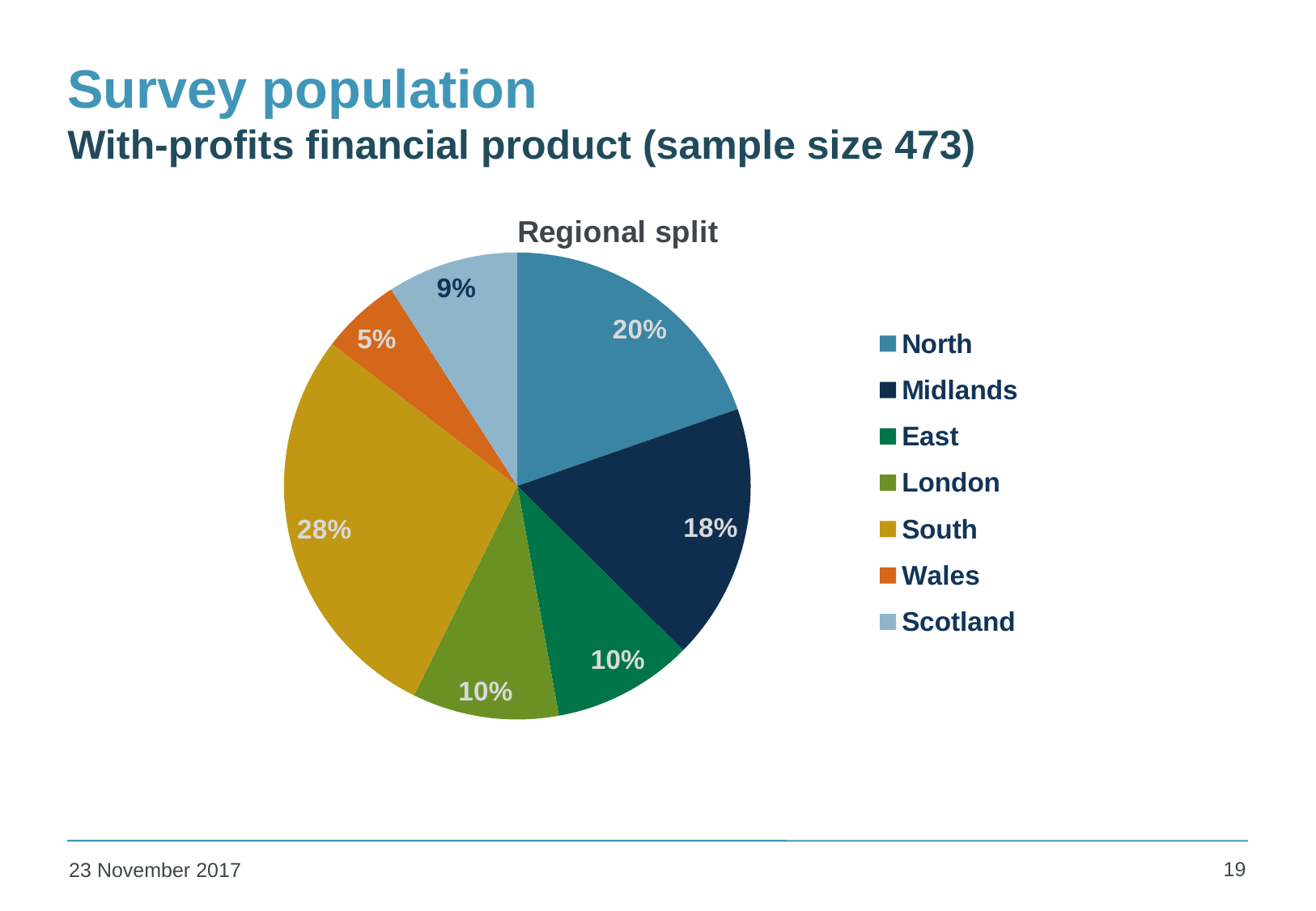
What is the value for Scotland? 9% Which region has the largest share of the pie? South What is the title of the chart? Regional split What is the value for Wales? 5% What is the value for North? 20% What is the difference between the shares for South and North? 8% What share of the pie does South account for? 28% Which is larger, the share for Midlands or the share for Scotland? Midlands Which region has the smallest share of the pie? Wales What kind of chart is shown on the slide? pie chart How many regions does the legend list? 7 What is the value for Midlands? 18%